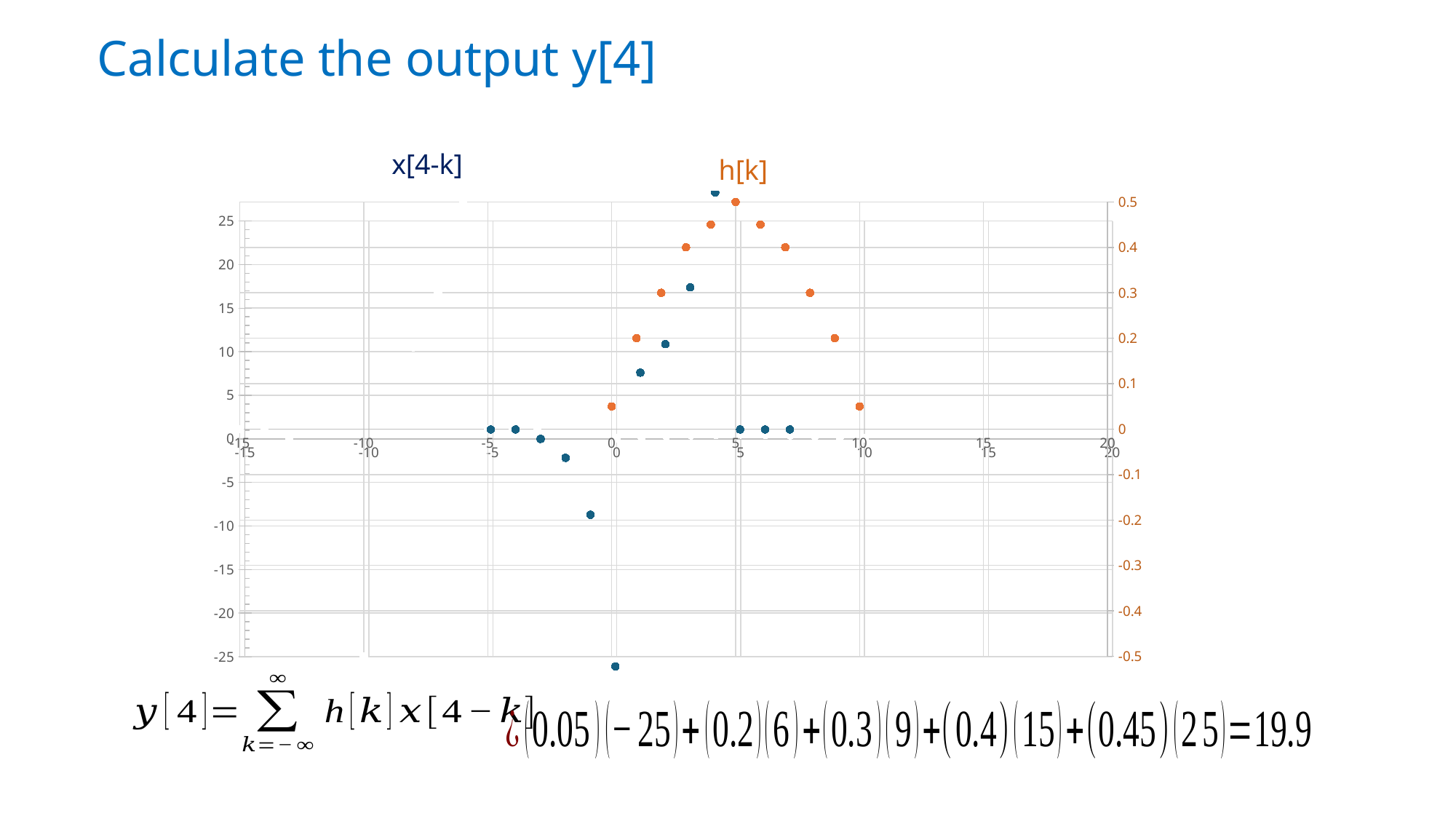
What are the names of the two series plotted on the chart? x[4-k] and h[k] Which colour is used for the h[k] series? orange Is the x[4-k] value at k = 0 greater or less than -20? less Do the h[k] values rise or fall as k goes from 5 to 10? fall Which is larger, the x[4-k] value at k = 3 or at k = 2? k = 3 Is the h[k] value at k = 1 greater or less than 0.1? greater Is the h[k] value at k = 5 greater or less than 0.4? greater How many series are plotted on the chart? 2 What kind of chart is shown on the slide? scatter chart At which value of k does the x[4-k] series reach its lowest point? 0 At which value of k does the h[k] series reach its highest point? 5